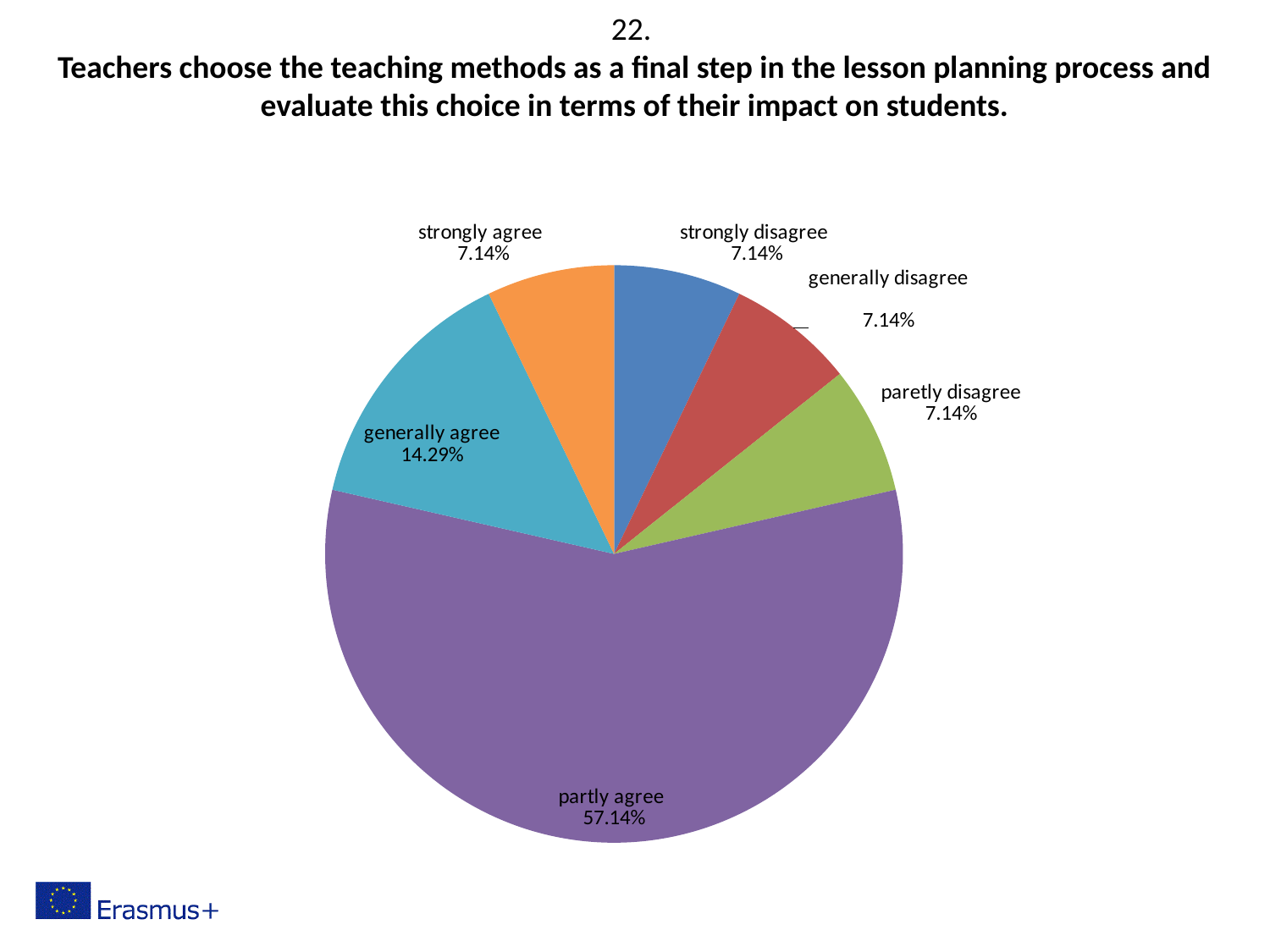
What is the difference between the values for "partly agree" and "generally agree"? 42.85% What share of the pie does "partly agree" take? 57.14% What kind of chart is shown on the slide? pie chart What is the value shown for "strongly agree"? 7.14% What is the value shown for "strongly disagree"? 7.14% What is the value shown for "paretly disagree"? 7.14% What colour is the "partly agree" slice? purple Which category has the largest slice of the pie? partly agree Which is larger, the value for "generally agree" or the value for "generally disagree"? generally agree What is the combined value of "strongly agree" and "generally agree"? 21.43% How many slices does the pie chart have? 6 What is the value shown for "generally agree"? 14.29%